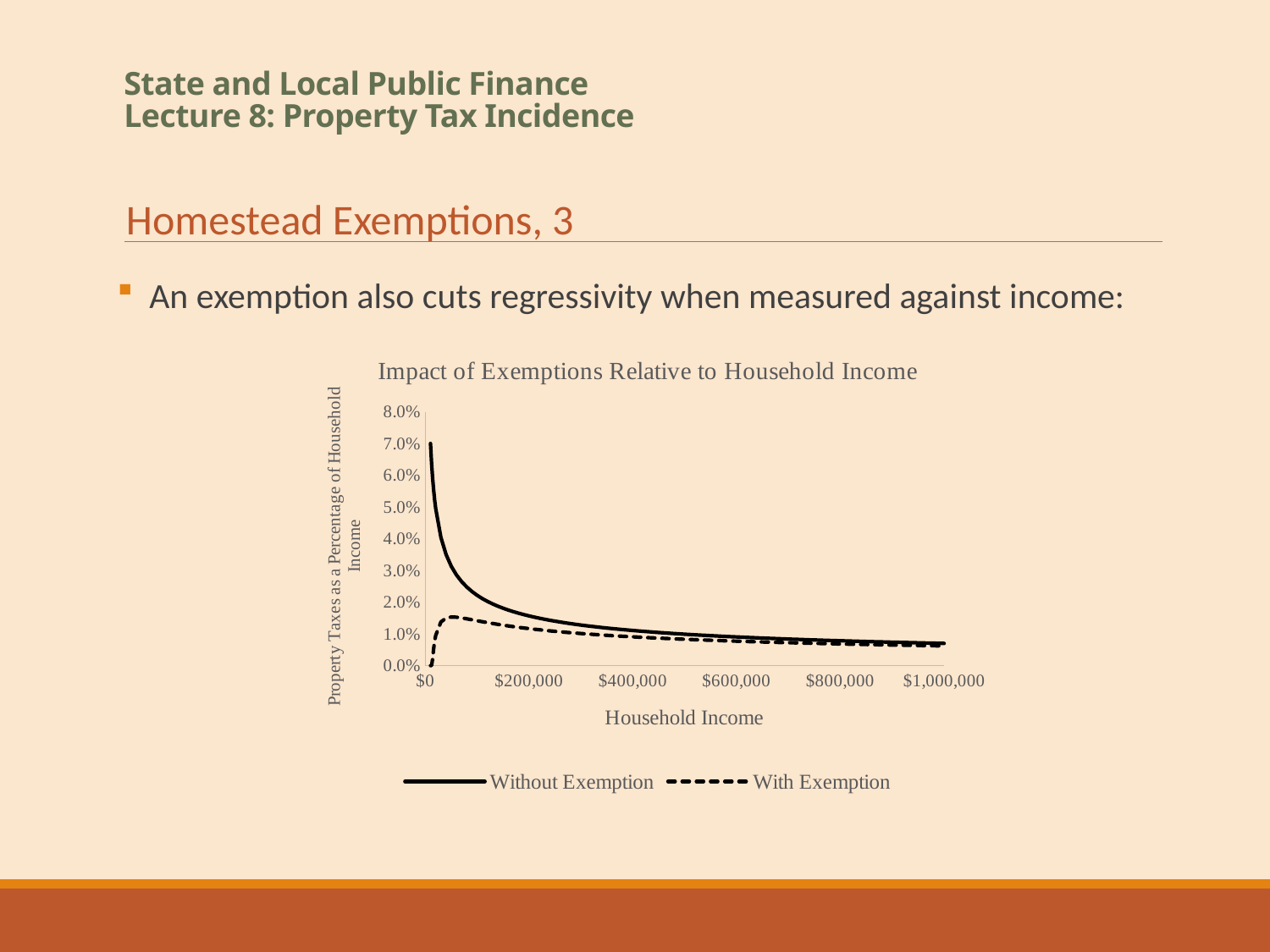
Is the highest value of the Without Exemption line greater or less than 6.0%? greater At a household income of $200,000, which series has the higher value, Without Exemption or With Exemption? Without Exemption What kind of chart is shown on the slide? line chart Is the value of the Without Exemption line at $1,000,000 greater or less than 1.0%? less Is the highest value of the With Exemption line greater or less than 2.0%? less What is the title of the chart? Impact of Exemptions Relative to Household Income Which series is drawn with a dashed line? With Exemption What is the highest tick value shown on the vertical axis? 8.0% Does the Without Exemption line rise or fall as household income increases? fall Beyond $200,000 of household income, does the With Exemption line rise or fall? fall How many series does the chart's legend list? 2